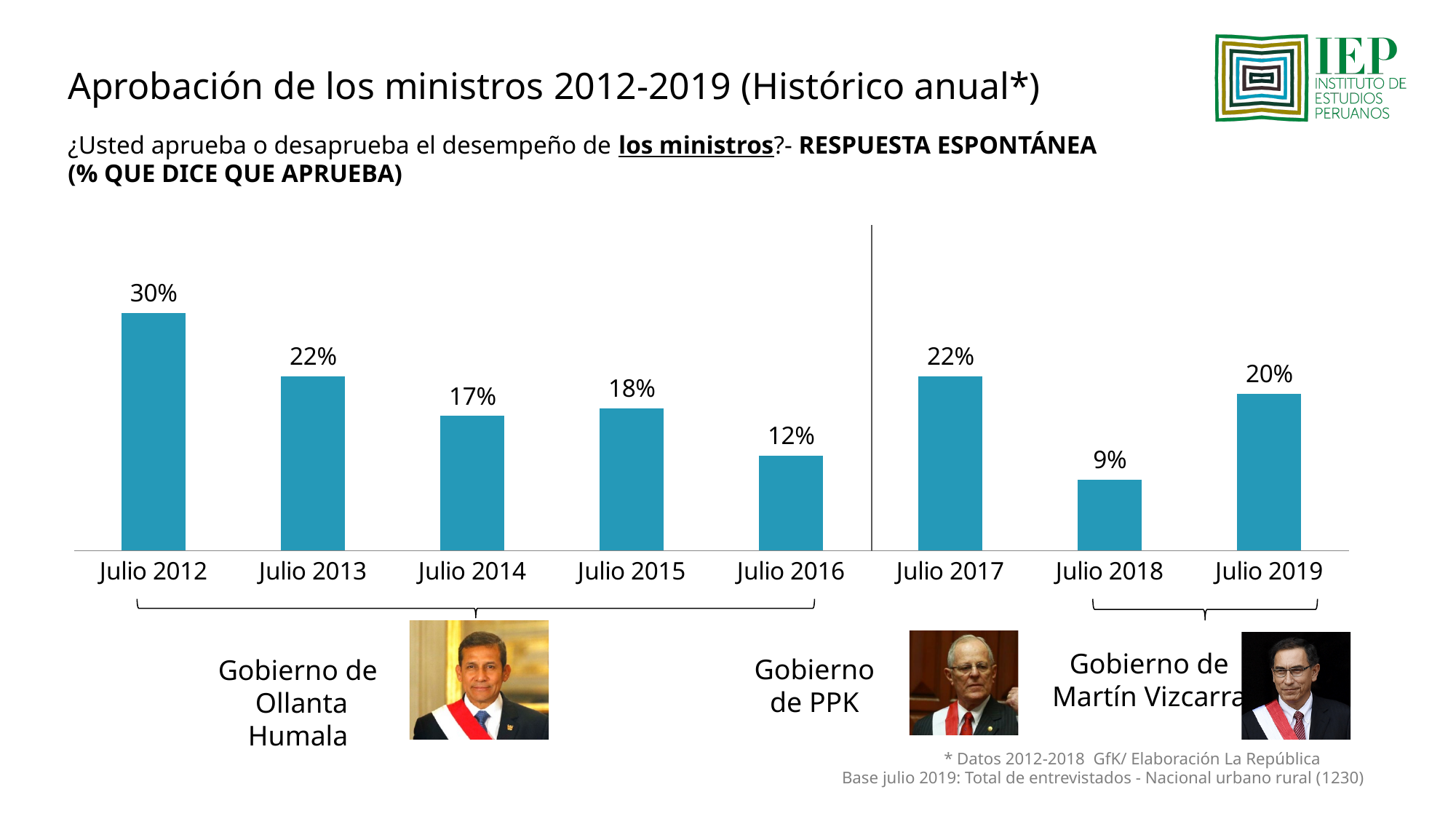
What is the difference between the values for Julio 2012 and Julio 2016? 18% What is the difference between the values for Julio 2019 and Julio 2018? 11% What is the approval value for Julio 2012? 30% Which period has the highest approval value? Julio 2012 What is the approval value for Julio 2018? 9% Which government do the bars for Julio 2012 to Julio 2016 correspond to, according to the bracket label? Gobierno de Ollanta Humala Which is larger, the value for Julio 2014 or the value for Julio 2015? Julio 2015 What kind of chart is shown on the slide? Bar chart Which period has the lowest approval value? Julio 2018 How many periods (bars) are shown in the chart? 8 What is the approval value for Julio 2019? 20% Do the values rise or fall from Julio 2012 to Julio 2016? Fall